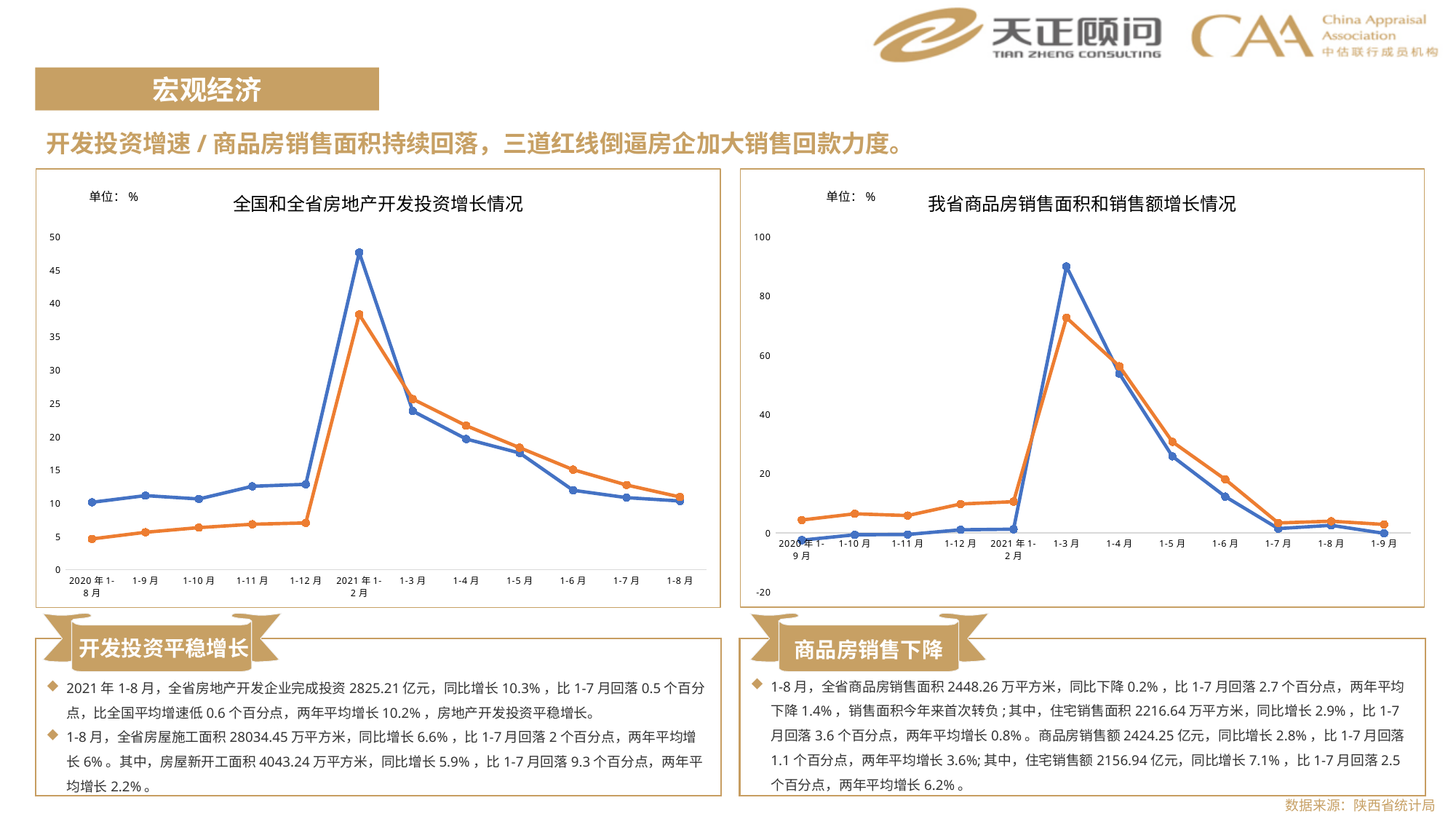
On the left chart 全国和全省房地产开发投资增长情况, at which x-axis category does the blue line reach its highest value? 2021年1-2月 How many lines are plotted on the right chart 我省商品房销售面积和销售额增长情况? 2 How many x-axis categories (time points) are plotted on the left chart 全国和全省房地产开发投资增长情况? 12 What type of chart is the left chart titled 全国和全省房地产开发投资增长情况? line chart On the right chart 我省商品房销售面积和销售额增长情况, do the values of the blue line rise or fall from 1-3月 to 1-9月? fall On the right chart 我省商品房销售面积和销售额增长情况, at which x-axis category does the orange line reach its highest value? 1-3月 On the right chart 我省商品房销售面积和销售额增长情况, is the orange line's value at 1-3月 greater or less than 60? greater On the left chart 全国和全省房地产开发投资增长情况, at which x-axis category is the orange line at its lowest value? 2020年1-8月 On the left chart 全国和全省房地产开发投资增长情况, at 2021年1-2月, which line has the higher value, the blue line or the orange line? the blue line What unit is shown for the values on the right chart 我省商品房销售面积和销售额增长情况? % On the right chart 我省商品房销售面积和销售额增长情况, is the blue line's value at 1-3月 greater or less than 80? greater On the left chart 全国和全省房地产开发投资增长情况, is the blue line's value at 2021年1-2月 greater or less than 45? greater